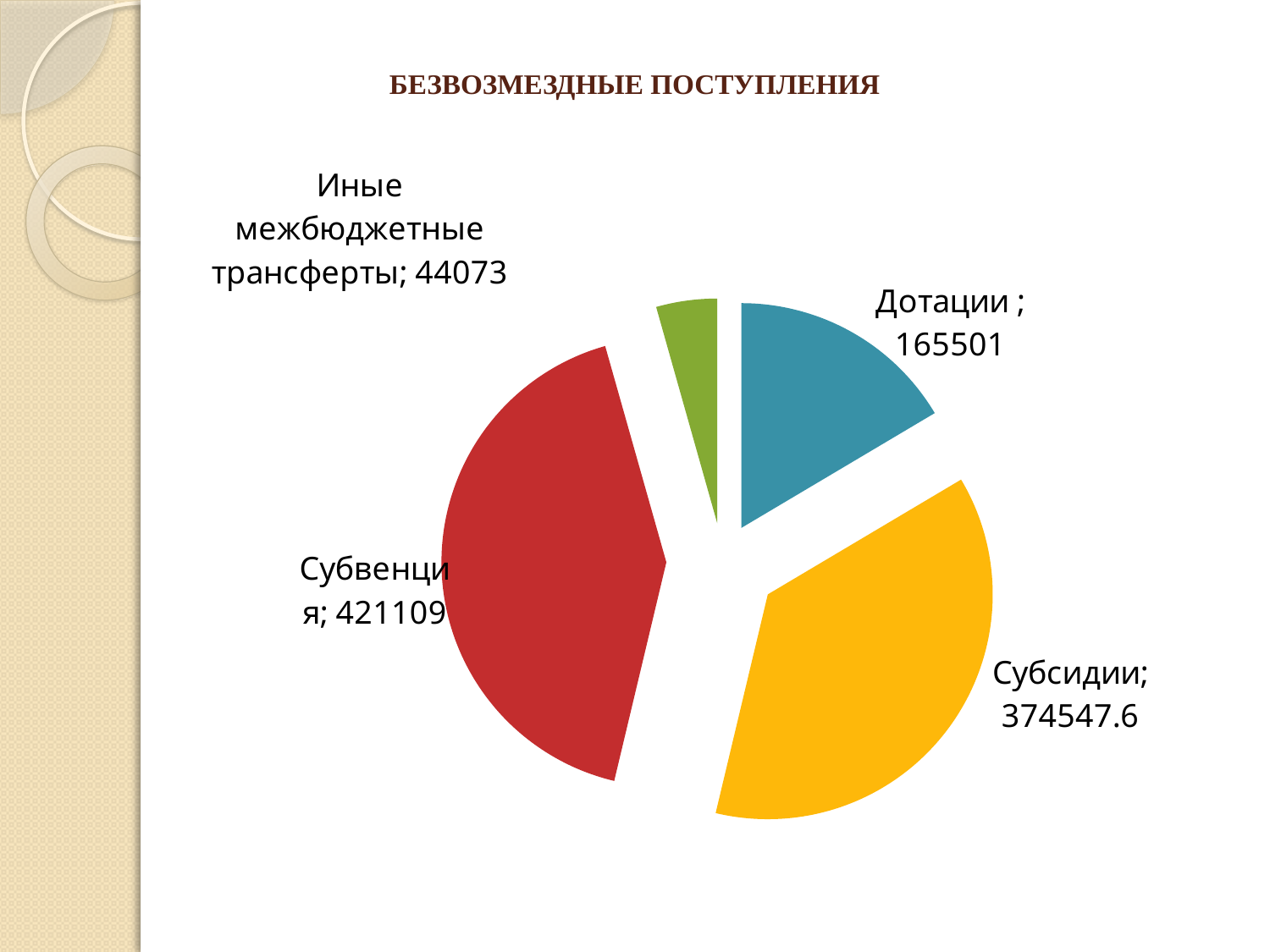
Which category has the largest slice? Субвенция What is the value for Иные межбюджетные трансферты? 44073 What is the difference between Субвенции and Субсидии? 46561.4 What colour is the slice for Субвенции? red What is the value for Дотации? 165501 What is the value for Субсидии? 374547.6 What type of chart is shown on the slide? pie chart Which is larger, Дотации or Субсидии? Субсидии What is the value for Субвенции? 421109 Which category has the smallest slice? Иные межбюджетные трансферты What is the title of the chart? БЕЗВОЗМЕЗДНЫЕ ПОСТУПЛЕНИЯ How many slices does the pie chart have? 4